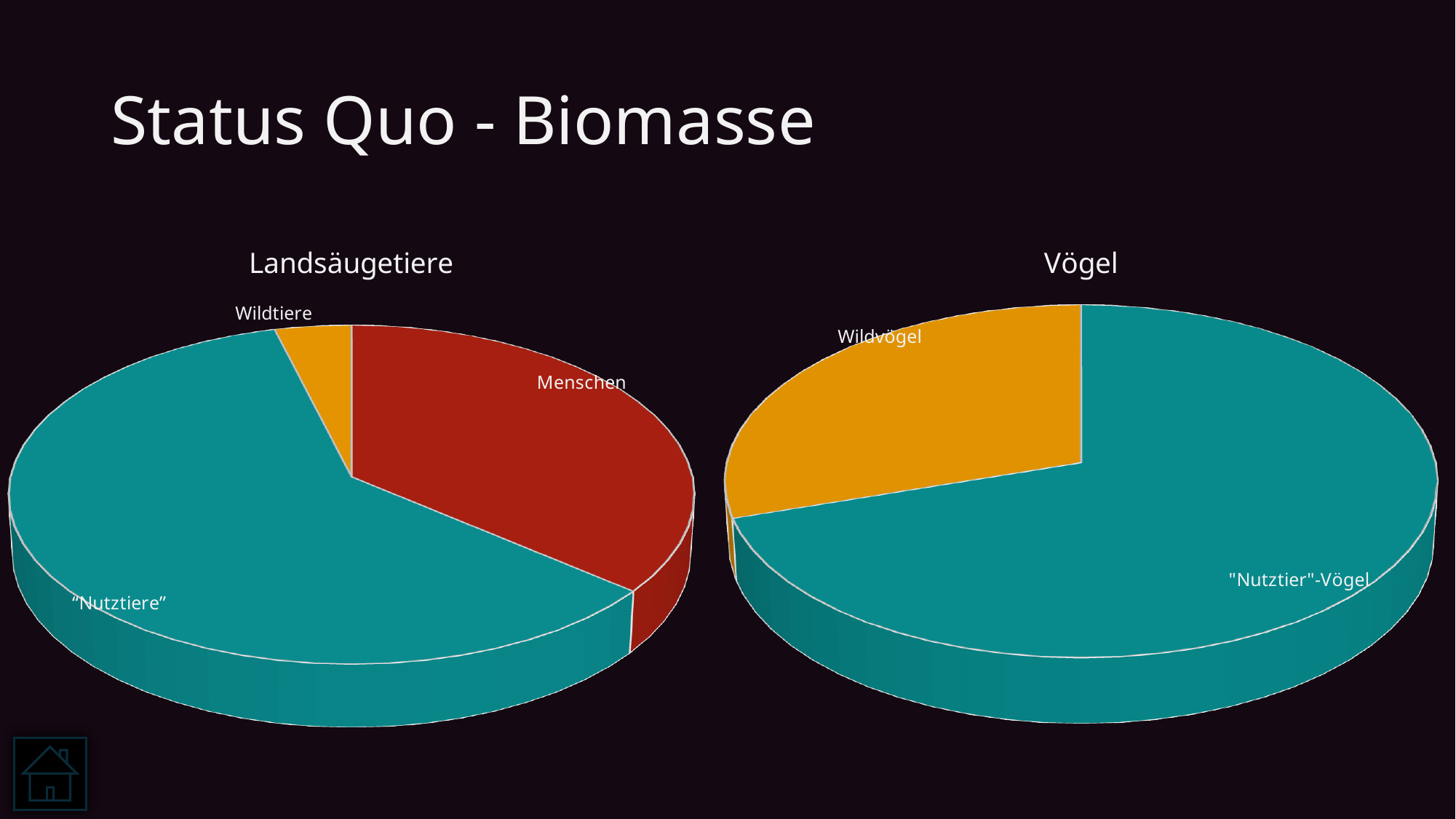
What kind of chart is the "Landsäugetiere" chart? Pie chart In the "Landsäugetiere" chart, which slice is the largest? "Nutztiere" In the "Vögel" chart, which is larger: Wildvögel or "Nutztier"-Vögel? "Nutztier"-Vögel How many slices does the "Vögel" pie chart have? 2 In the "Landsäugetiere" chart, which is larger: Menschen or Wildtiere? Menschen How many slices does the "Landsäugetiere" pie chart have? 3 In the "Landsäugetiere" chart, which slice is the smallest? Wildtiere What is the title of the pie chart on the right side of the slide? Vögel In the "Landsäugetiere" chart, what colour is the Menschen slice? Red In the "Vögel" chart, which slice is the smallest? Wildvögel What kind of chart is the "Vögel" chart? Pie chart In the "Vögel" chart, which slice is the largest? "Nutztier"-Vögel